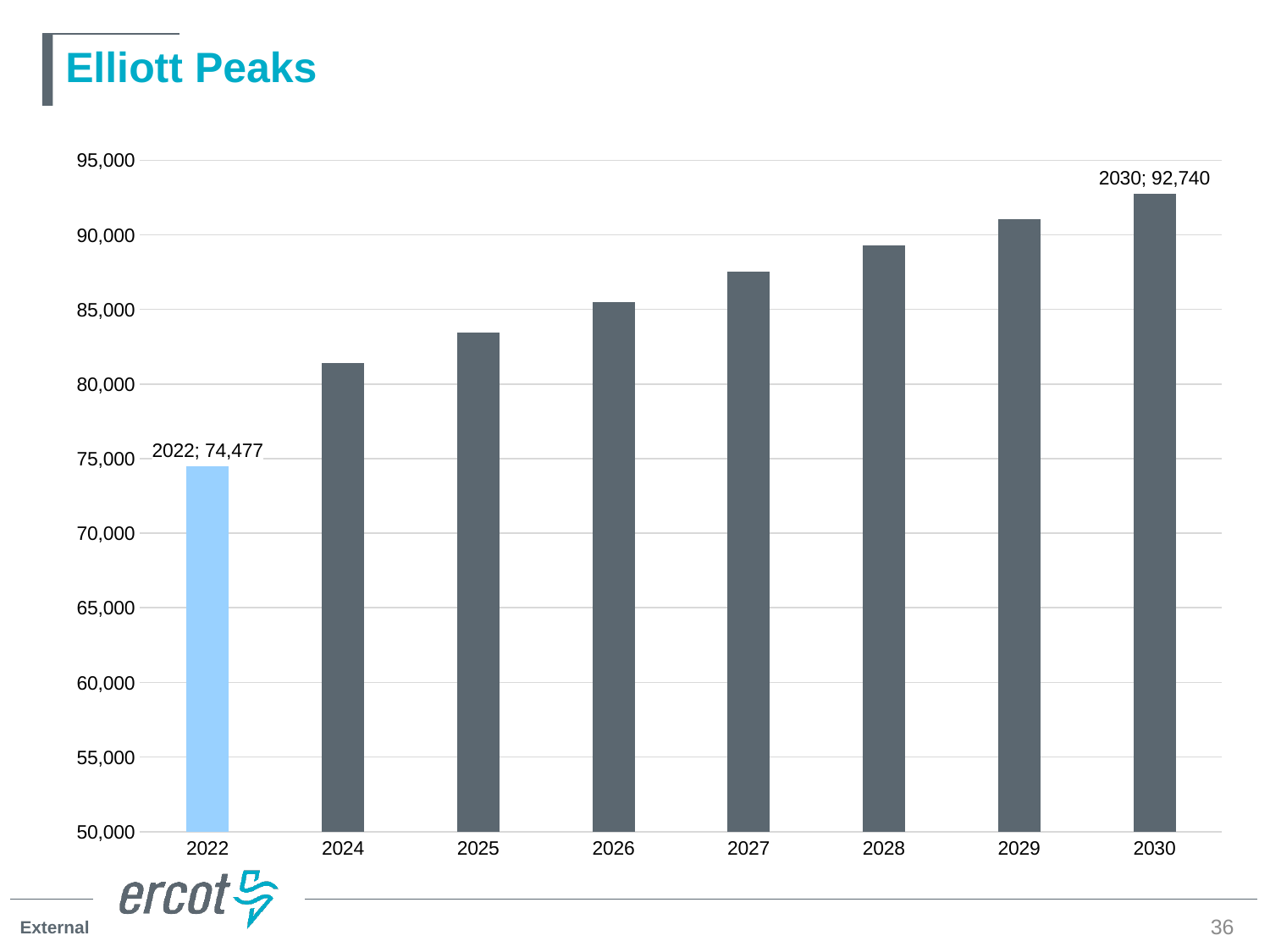
Is the value for 2029 greater or less than 90,000? greater Which is larger, the value for 2026 or the value for 2028? 2028 Which year has the lowest value? 2022 Is the value for 2027 greater or less than 90,000? less Do the values rise or fall from 2022 to 2030? rise Is the value for 2024 greater or less than 80,000? greater What is the value for 2030? 92,740 Which year has the highest value? 2030 What is the value for 2022? 74,477 What is the difference between the values for 2030 and 2022? 18,263 What kind of chart is shown? bar chart How many years are shown on the x axis? 8